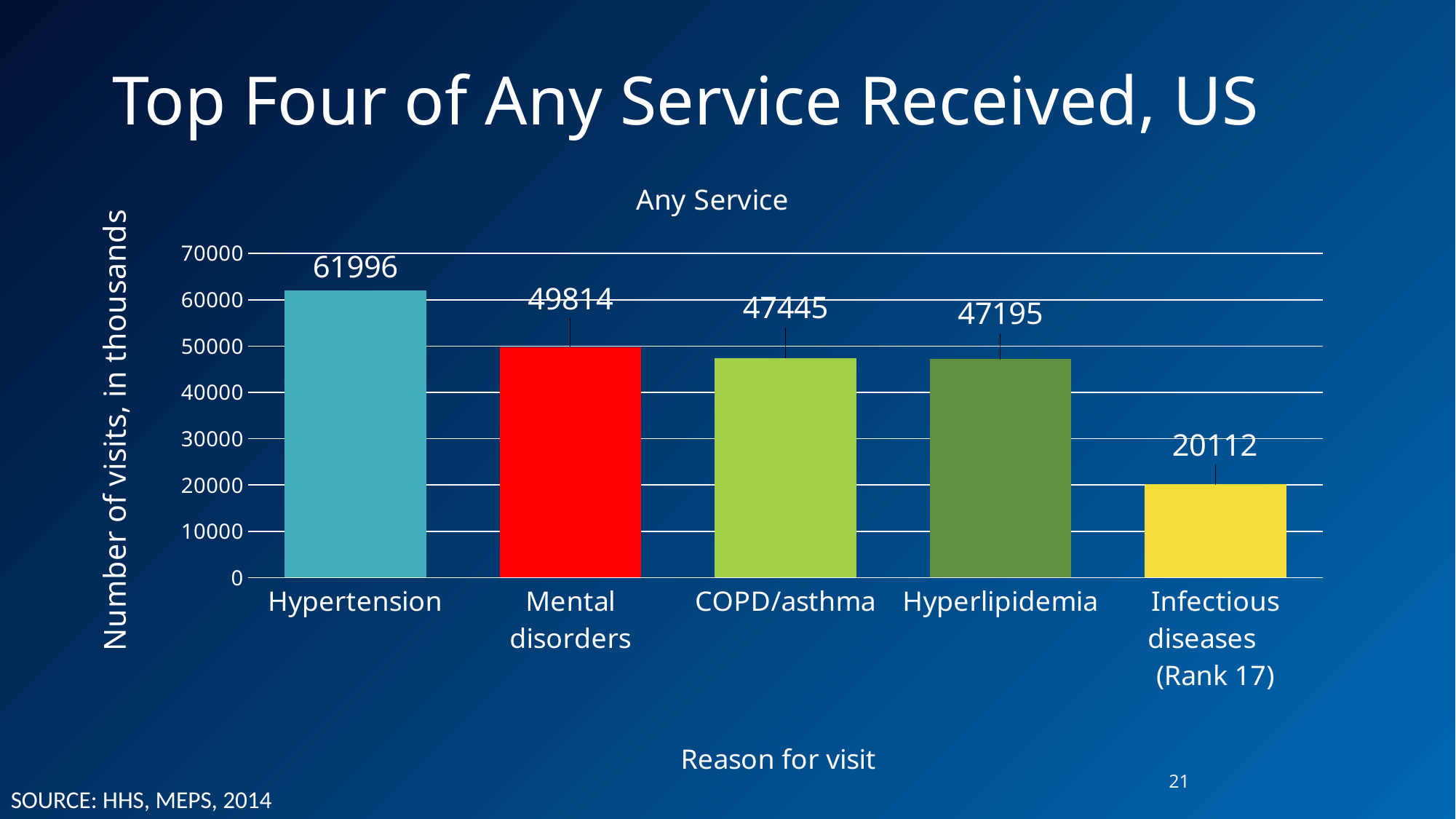
What is the title of the chart? Any Service Which category has the highest value? Hypertension How many categories are shown on the x axis? 5 What kind of chart is this? bar chart Which category has the lowest value? Infectious diseases (Rank 17) Is the value for Hyperlipidemia greater or less than 50000? less What is the value for Mental disorders? 49814 What is the difference between the values for Hypertension and Mental disorders? 12182 What is the value for Infectious diseases (Rank 17)? 20112 What is the difference between the values for COPD/asthma and Hyperlipidemia? 250 Which is larger, the value for Mental disorders or the value for Infectious diseases (Rank 17)? Mental disorders What is the value for Hypertension? 61996